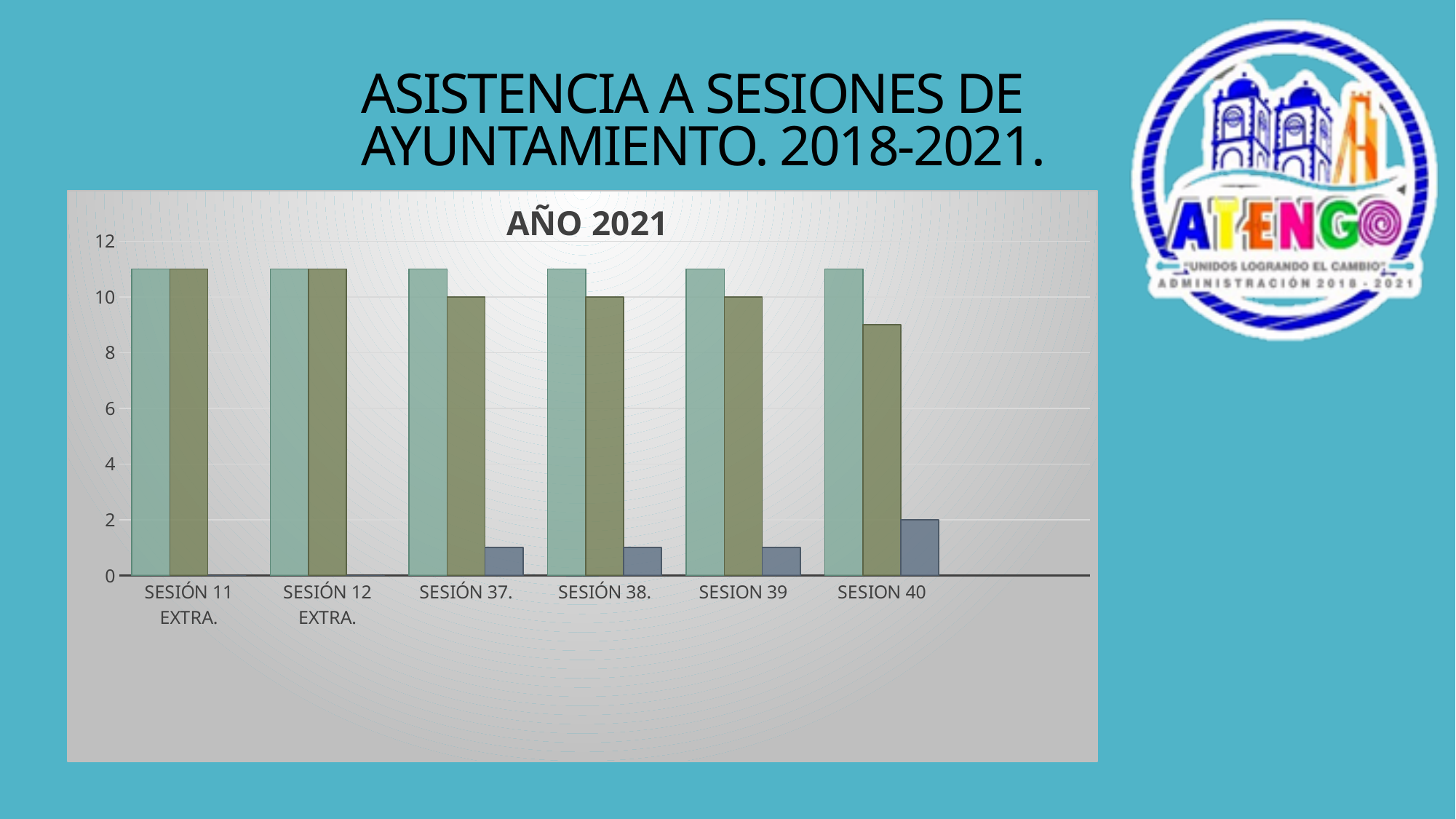
What is the highest value shown on the vertical axis of the chart? 12 Which session has the highest dark blue (third) bar? SESION 40 Is the value of the middle (olive) bar for SESION 40 greater or less than 10? less What kind of chart is shown on the slide? bar chart Do the values of the middle (olive) bars rise or fall from SESIÓN 11 EXTRA. to SESION 40? fall Which has the larger middle (olive) bar, SESIÓN 12 EXTRA. or SESIÓN 37.? SESIÓN 12 EXTRA. What is the title of the chart? AÑO 2021 Is the value of the first (light teal) bar for SESIÓN 11 EXTRA. greater or less than 10? greater What is the value of the dark blue (third) bar for SESION 40? 2 Is the value of the dark blue (third) bar for SESIÓN 38. greater or less than 2? less How many sessions (categories) are shown on the x axis of the chart? 6 What is the value of the middle (olive) bar for SESIÓN 37.? 10